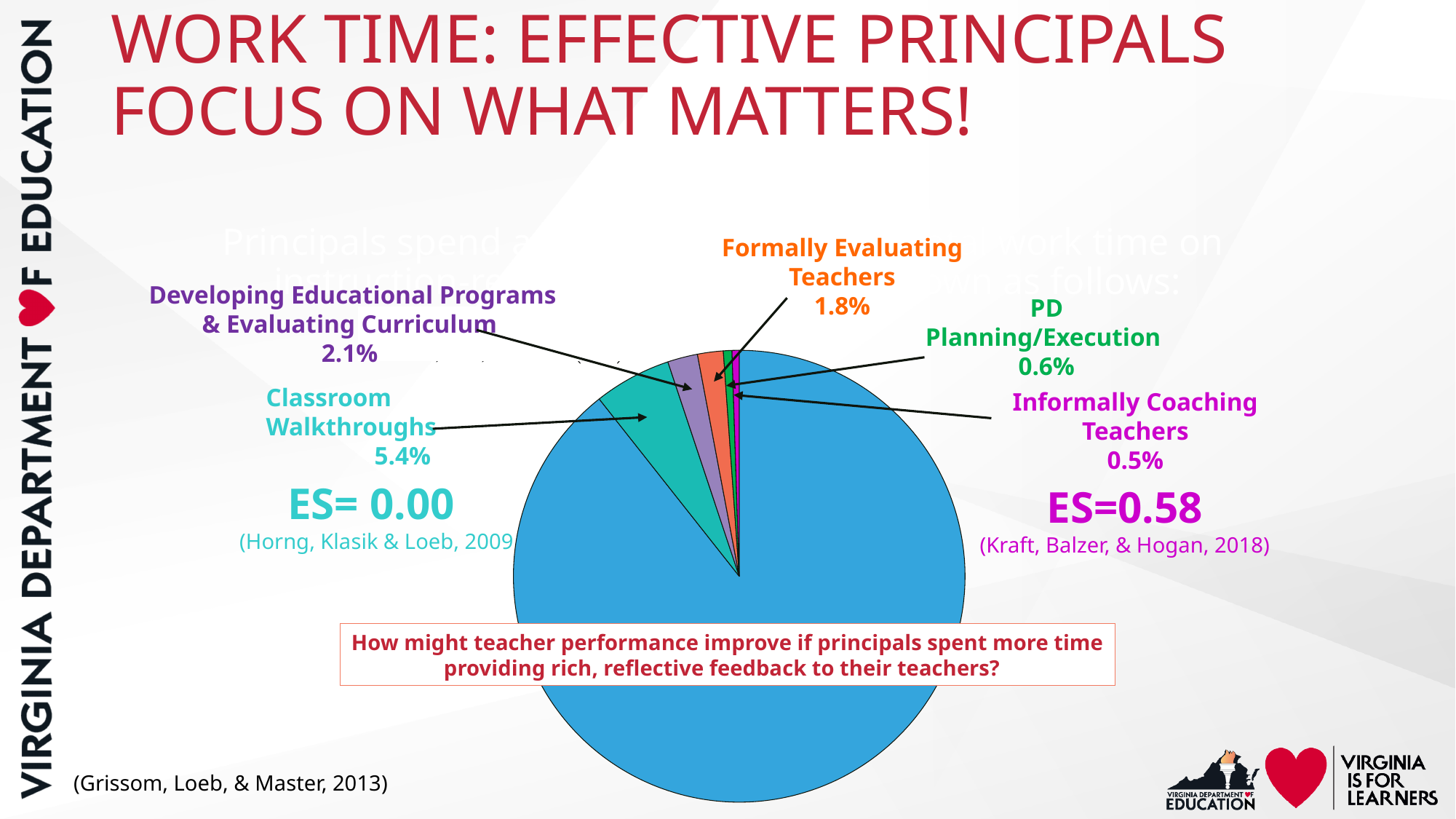
Among the labeled slices, which has the smallest percentage? Informally Coaching Teachers What percentage is shown for Developing Educational Programs & Evaluating Curriculum? 2.1% What percentage of work time is shown for Classroom Walkthroughs? 5.4% How many slices of the pie have a percentage label? 5 What percentage is shown for Formally Evaluating Teachers? 1.8% What is the difference in percentage points between Classroom Walkthroughs and Developing Educational Programs & Evaluating Curriculum? 3.3 What percentage is shown for PD Planning/Execution? 0.6% Which is larger, the percentage for Classroom Walkthroughs or for Formally Evaluating Teachers? Classroom Walkthroughs What colour is the Formally Evaluating Teachers slice? orange What effect size (ES) is shown next to Informally Coaching Teachers? ES=0.58 What percentage is shown for Informally Coaching Teachers? 0.5% What kind of chart is shown on the slide? pie chart